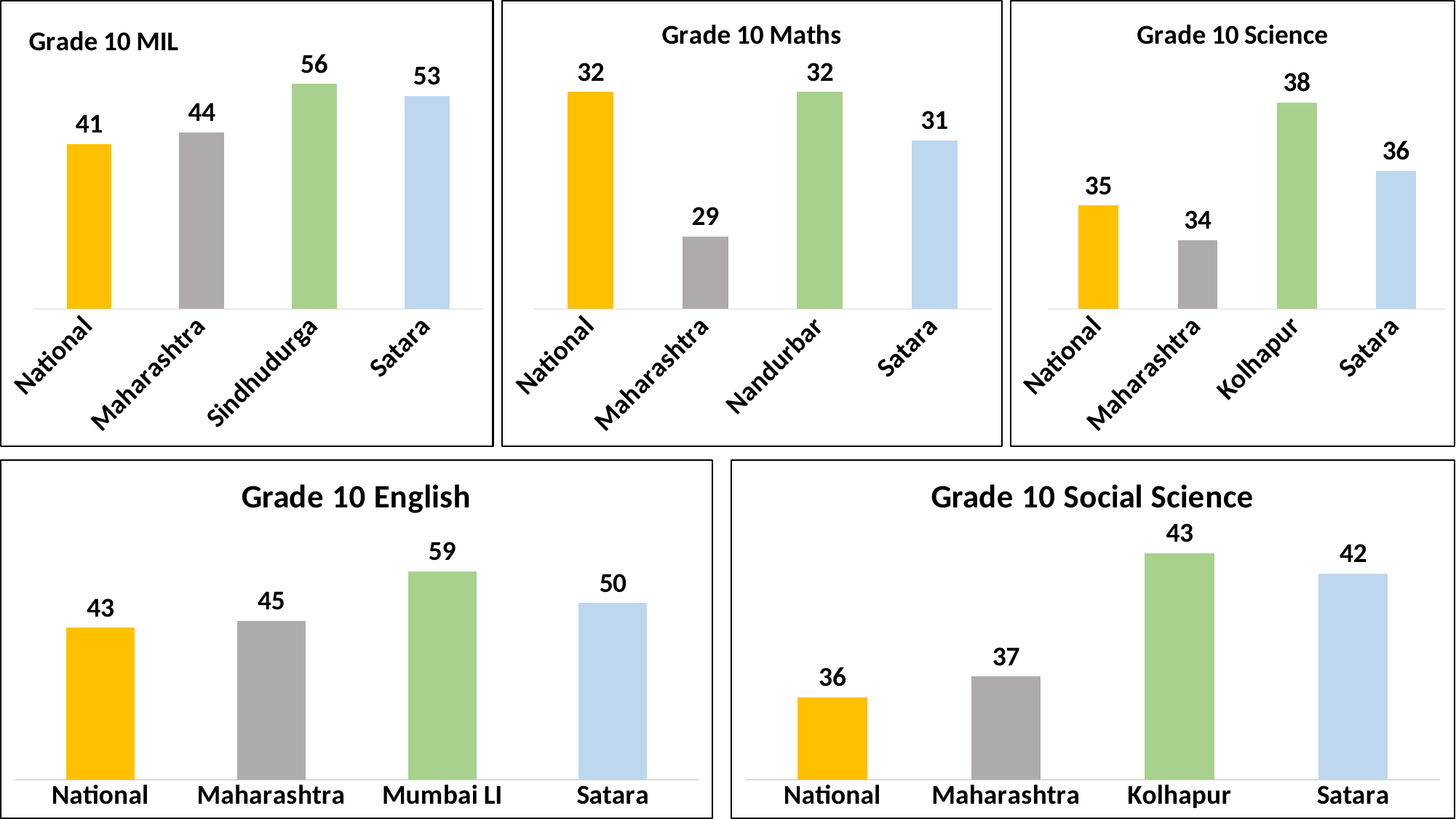
In the Grade 10 Science chart, what is the value for Kolhapur? 38 In the Grade 10 MIL chart, which is larger, the value for Maharashtra or the value for Satara? Satara In the Grade 10 Social Science chart, what is the difference between Kolhapur and National? 7 In the Grade 10 English chart, what is the difference between Mumbai LI and Maharashtra? 14 In the Grade 10 Maths chart, which category has the lowest value? Maharashtra In the Grade 10 Science chart, what is the value for National? 35 In the Grade 10 MIL chart, what is the value for Sindhudurga? 56 What kind of chart is the Grade 10 English chart? Bar chart In the Grade 10 English chart, which category has the highest value? Mumbai LI How many charts are shown on the slide? 5 How many categories are shown in the Grade 10 Maths chart? 4 In the Grade 10 Social Science chart, what is the value for Satara? 42